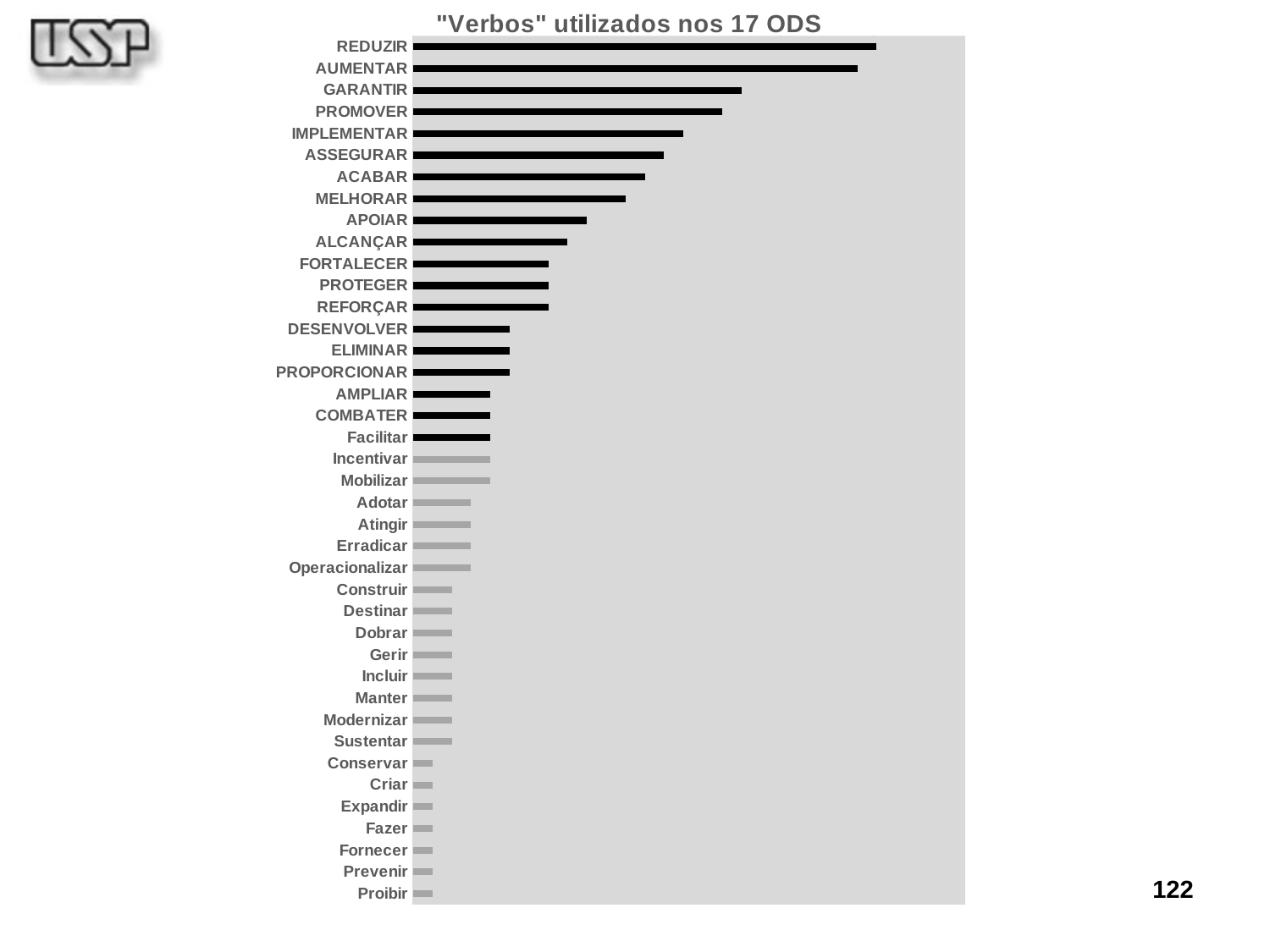
Which has the larger value, APOIAR or MELHORAR? MELHORAR What colour are the bars for the verbs written in capital letters, such as REDUZIR and AUMENTAR? Black Which has the larger value, ASSEGURAR or ACABAR? ASSEGURAR How many verbs (categories) are listed in the chart? 40 Which has the larger value, PROMOVER or IMPLEMENTAR? PROMOVER What kind of chart is shown on the slide? Bar chart Which verb has the longest bar in the chart? REDUZIR Do the bar lengths increase or decrease going from the top of the chart to the bottom? Decrease Which verb has the second-longest bar in the chart? AUMENTAR What is the title of the chart? "Verbos" utilizados nos 17 ODS